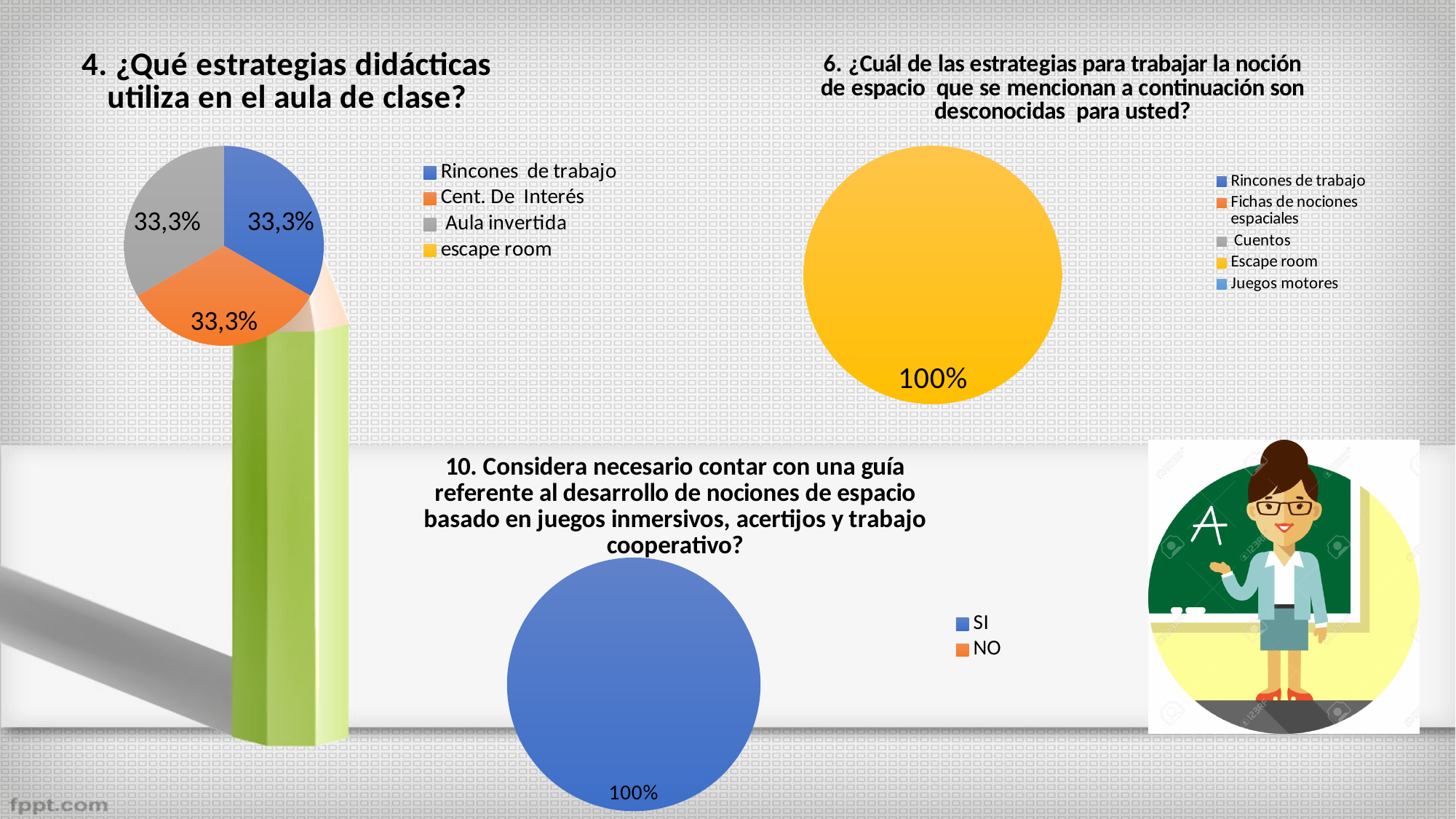
How many entries does the legend of the chart for question 4 list? 4 What kind of chart is used for question 4? Pie chart How many entries does the legend of the chart for question 10 list? 2 In the chart for question 4 (¿Qué estrategias didácticas utiliza en el aula de clase?), what share does Rincones de trabajo have? 33,3% In the chart for question 10, which of SI or NO has the larger share? SI In the chart for question 6, which category makes up the whole pie? Escape room How many entries does the legend of the chart for question 6 list? 5 In the chart for question 4, what percentage is shown for Aula invertida? 33,3% In the chart for question 4, what percentage is shown for Cent. De Interés? 33,3% In the chart for question 6 (estrategias desconocidas), what percentage is shown for Escape room? 100% In the chart for question 10 (guía referente al desarrollo de nociones de espacio), what percentage is shown for SI? 100% In the chart for question 4, which legend entry is shown in yellow? escape room